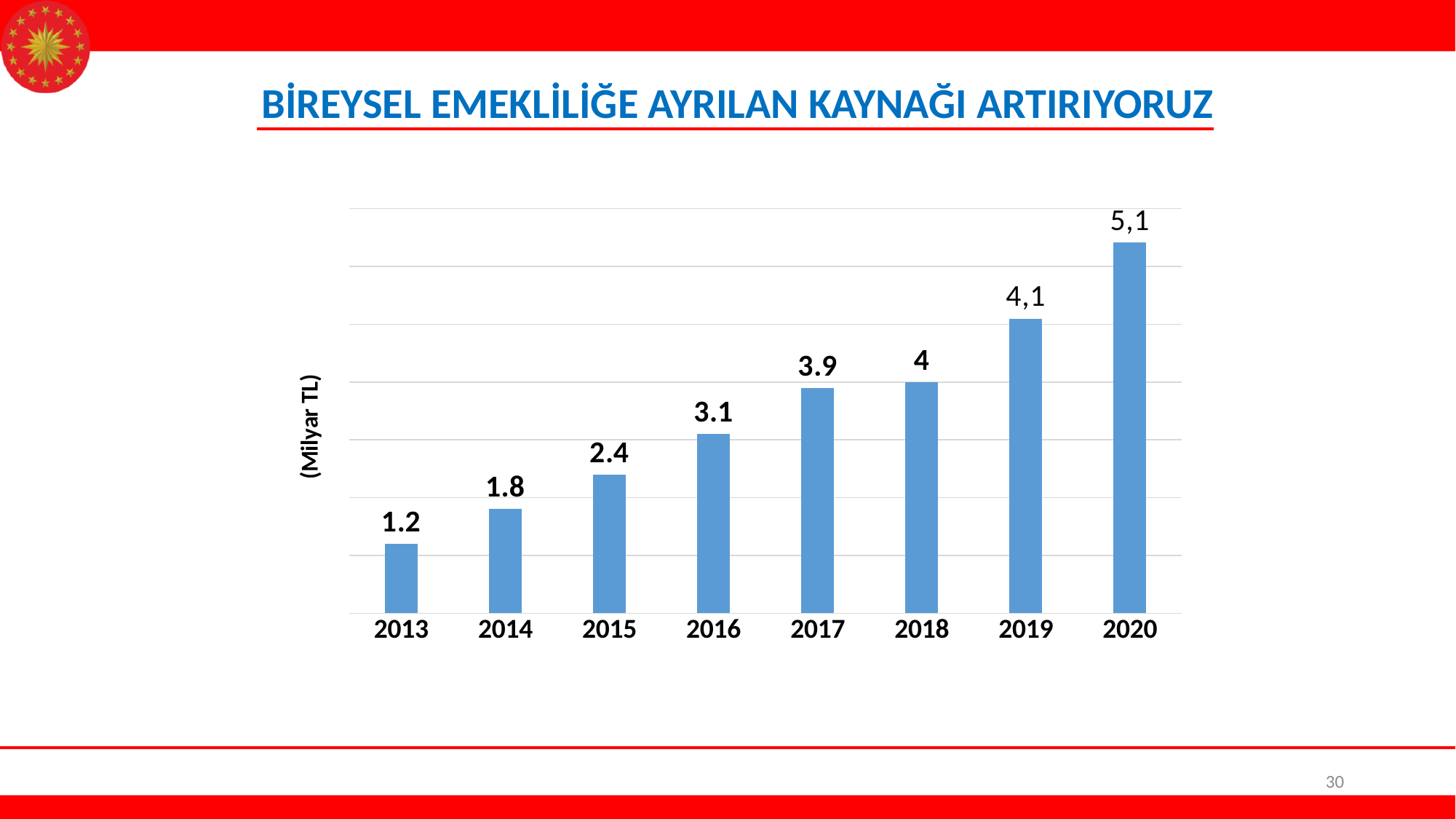
Which is larger, the value for 2016 or the value for 2018? 2018 Do the values rise or fall from 2013 to 2020? Rise Which year has the lowest value? 2013 What kind of chart is shown on the slide? Bar chart What is the value for 2020? 5,1 What is the difference between the values for 2017 and 2013? 2.7 What is the value for 2017? 3.9 What is the value for 2013? 1.2 How many years are shown on the x axis? 8 What is the value for 2019? 4,1 What is the difference between the values for 2020 and 2019? 1 Which year has the highest value? 2020